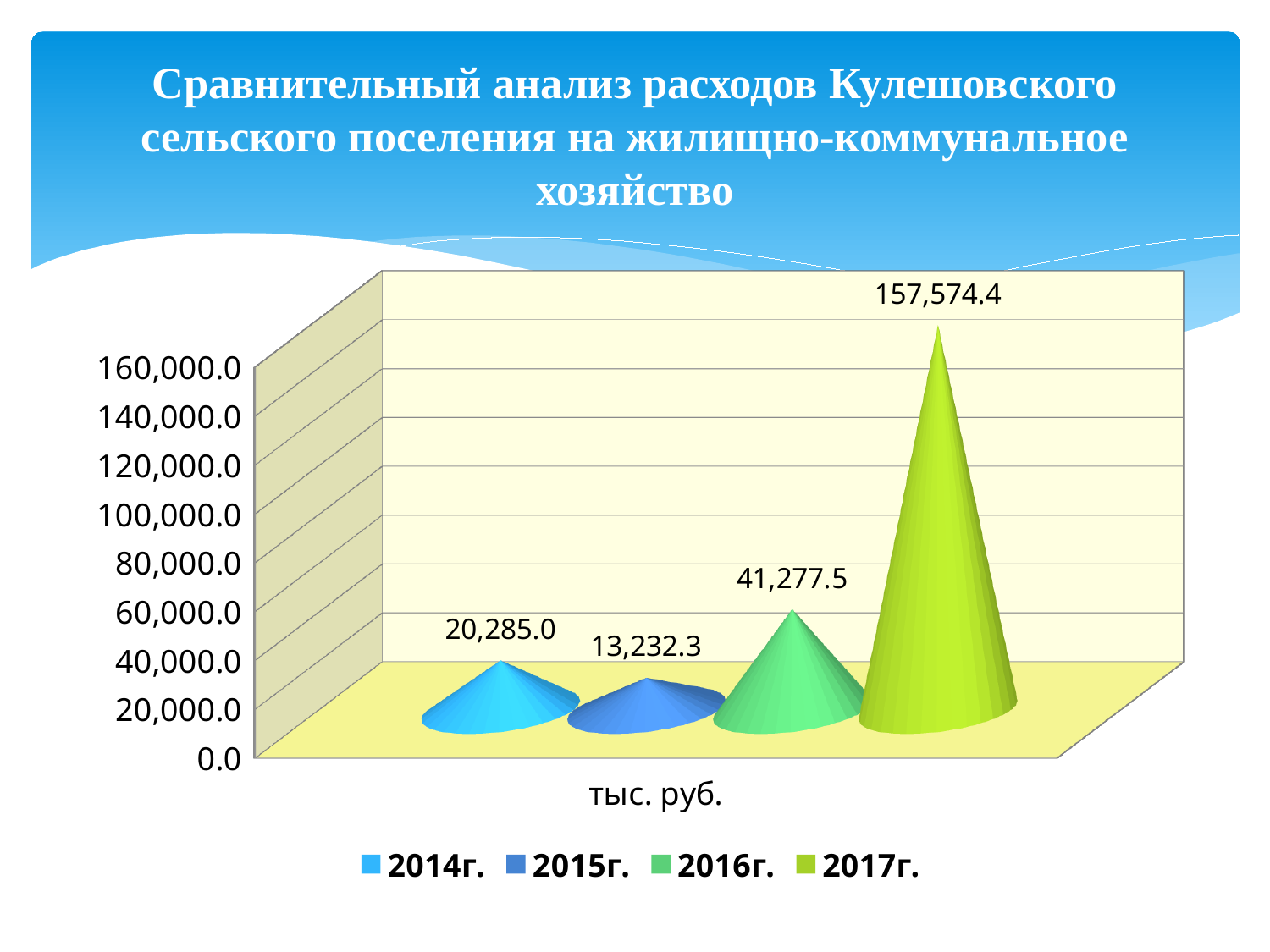
What is the value for 2016г.? 41,277.5 What is the difference between the values for 2014г. and 2015г.? 7,052.7 What is the value for 2015г.? 13,232.3 What is the value for 2017г.? 157,574.4 What is the difference between the values for 2017г. and 2016г.? 116,296.9 What kind of chart is shown on the slide? bar chart Which year has the lowest value? 2015г. Is the value for 2017г. greater or less than 140,000.0? greater How many series does the legend list? 4 Which is larger, the value for 2016г. or the value for 2014г.? 2016г. Which year has the highest value? 2017г. What is the value for 2014г.? 20,285.0